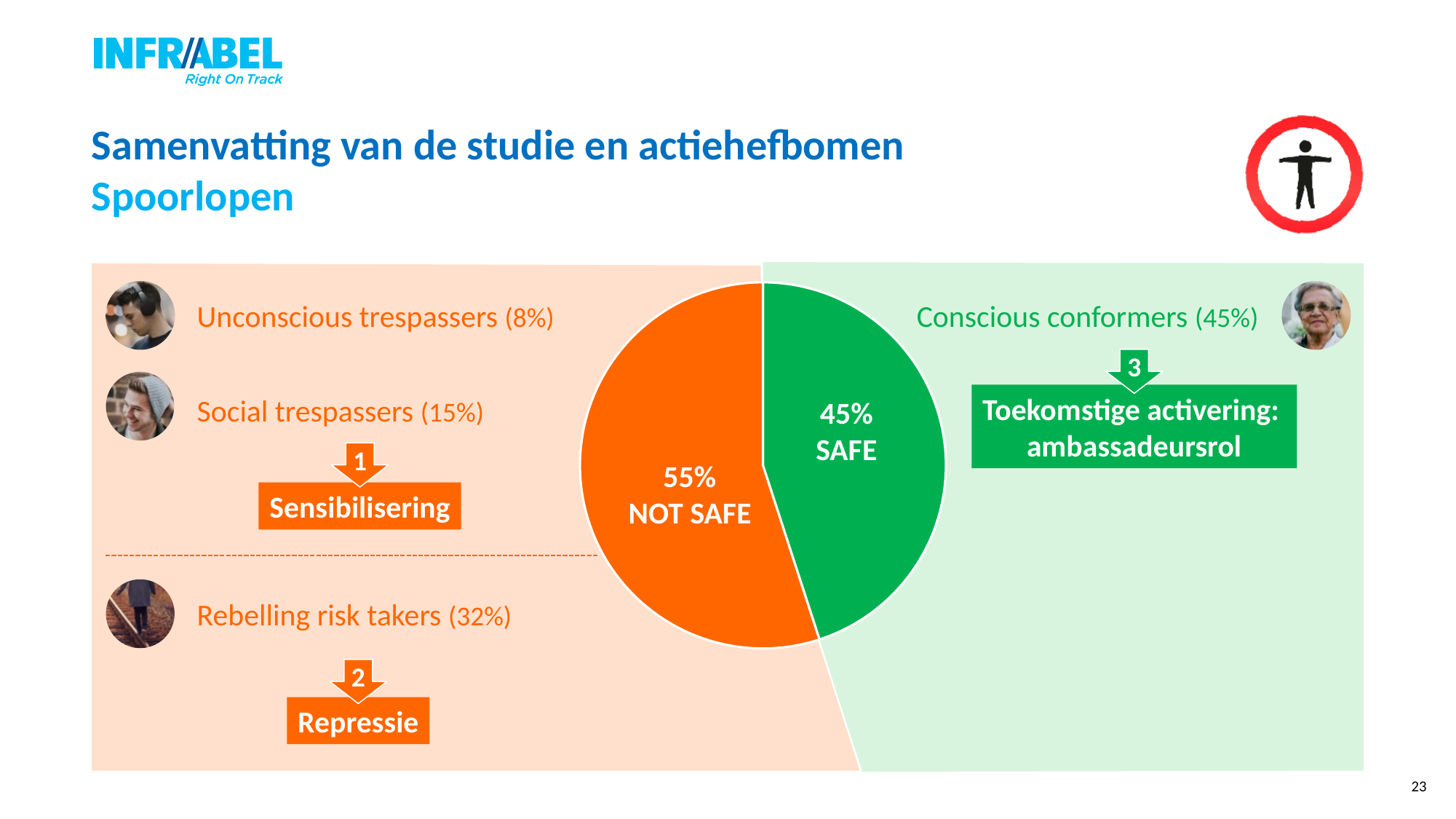
What is the difference in percentage points between the NOT SAFE slice and the SAFE slice? 10 Which slice of the pie is larger, NOT SAFE or SAFE? NOT SAFE What colour is the NOT SAFE slice of the pie? orange What share of the pie is labelled SAFE? 45% Which slice of the pie is the smallest? SAFE What colour is the SAFE slice of the pie? green What share of the pie is labelled NOT SAFE? 55% What kind of chart is shown on the slide? pie chart How many slices does the pie chart have? 2 What percentage is given for Rebelling risk takers on the slide? 32% What percentage is given for Conscious conformers on the slide? 45% Is the NOT SAFE share of the pie greater or less than 50%? greater